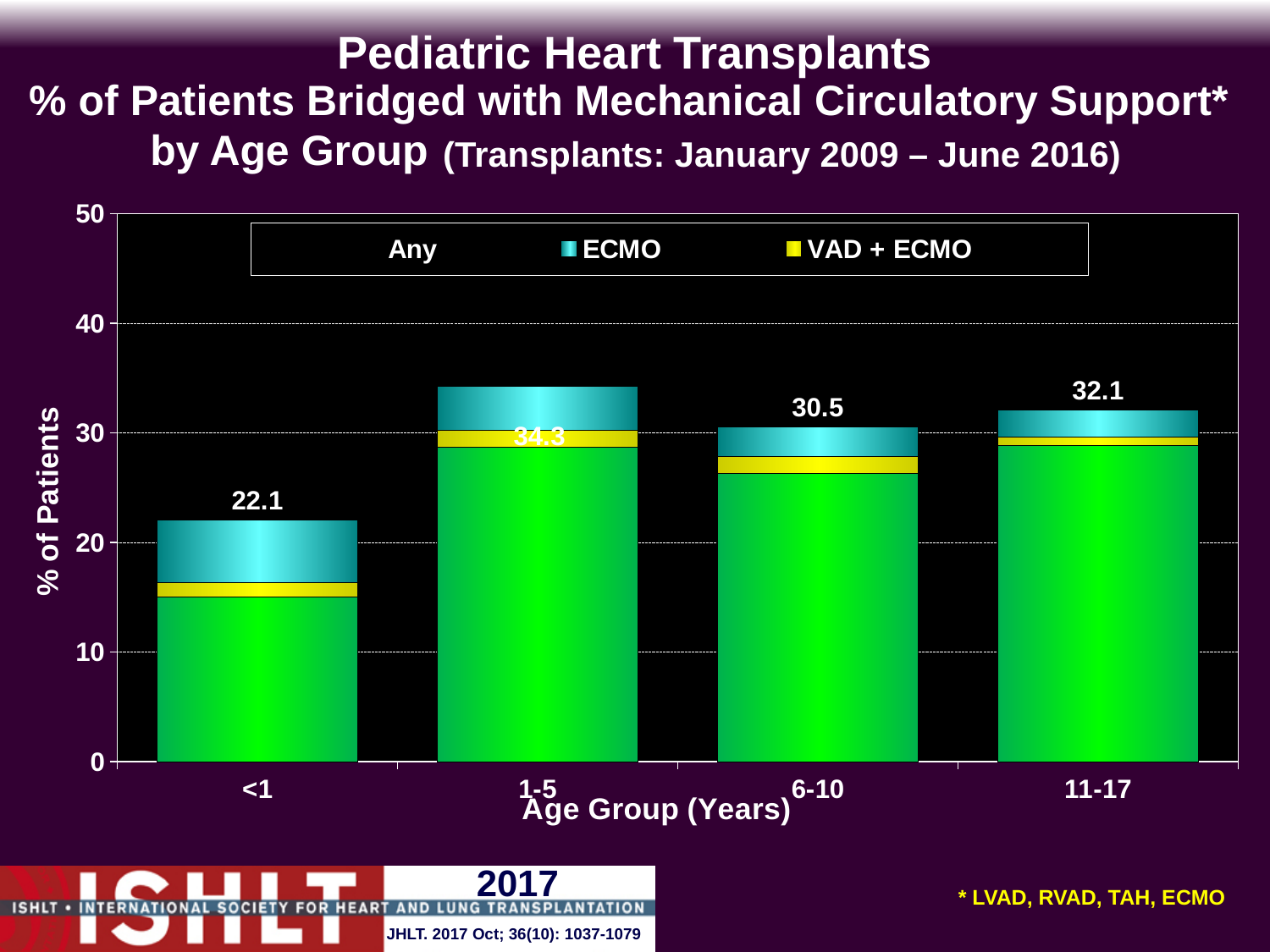
Which age group has a larger total value, 6-10 or 11-17? 11-17 How many series does the legend list? 3 Which age group has the lowest total percentage of patients bridged with mechanical circulatory support? <1 Which age group has the highest total percentage of patients bridged with mechanical circulatory support? 1-5 What is the total percentage of patients bridged with mechanical circulatory support in the <1 age group? 22.1 What is the total value shown for the 6-10 age group? 30.5 What is the difference between the total values for the 1-5 and <1 age groups? 12.2 What kind of chart is shown on the slide? Stacked bar chart Is the total value for the <1 age group greater or less than 30? less How many age groups are shown on the x axis? 4 What is the total value shown for the 1-5 age group? 34.3 What is the total value shown for the 11-17 age group? 32.1